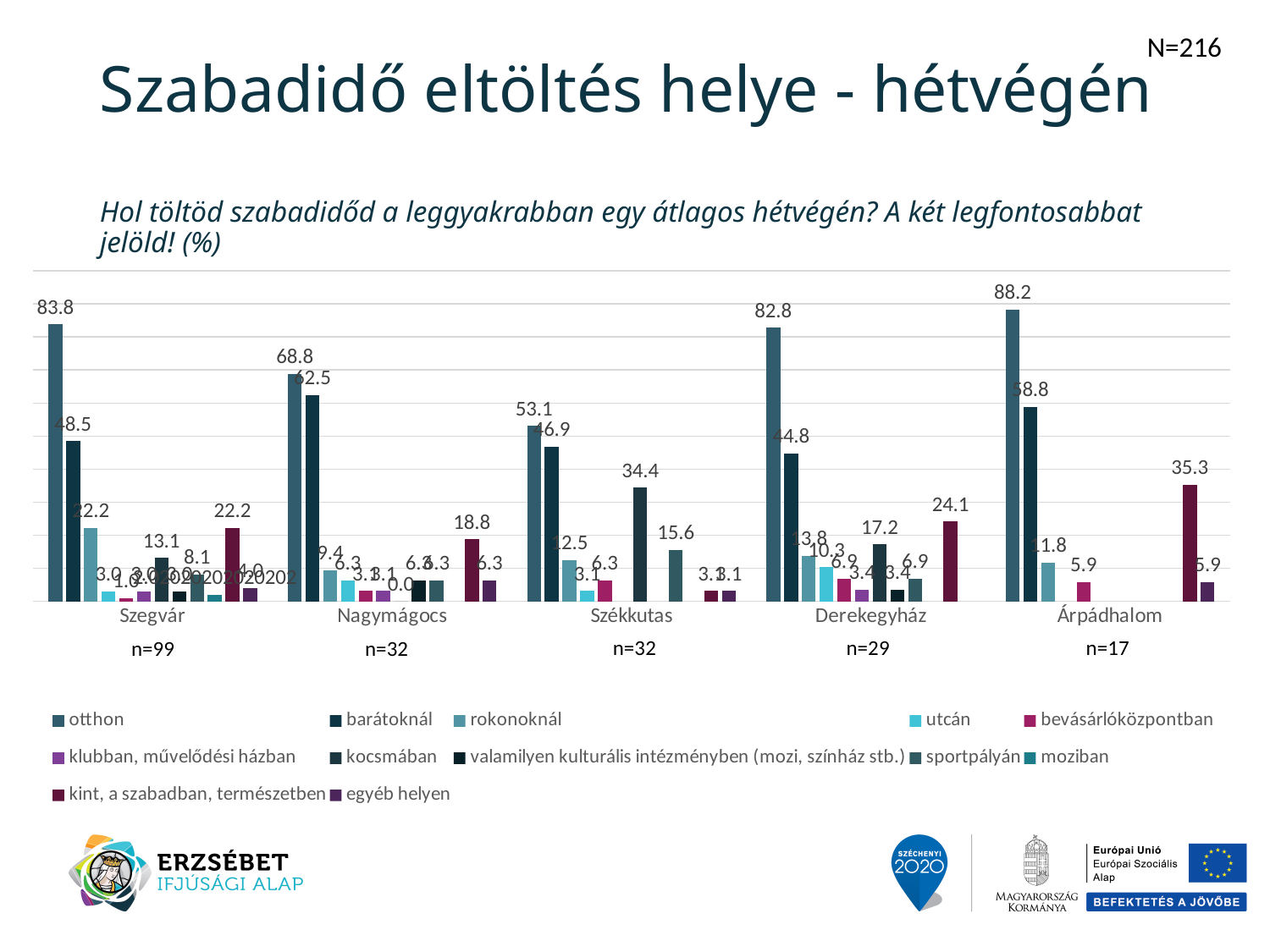
What type of chart is shown on the slide? bar chart What is the value for 'barátoknál' in Nagymágocs? 62.5 How many settlement categories are shown on the x axis? 5 What is the value for 'kint, a szabadban, természetben' in Árpádhalom? 35.3 What is the sample size (n) shown for Szegvár? n=99 How many series does the legend list? 12 What is the value for 'otthon' in Árpádhalom? 88.2 Which is larger in Derekegyház: 'otthon' or 'barátoknál'? otthon Which settlement has the highest value for 'otthon'? Árpádhalom Which settlement has the lowest value for 'otthon'? Székkutas What is the value for 'kocsmában' in Székkutas? 34.4 What is the difference between the 'otthon' values for Szegvár and Nagymágocs? 15.0